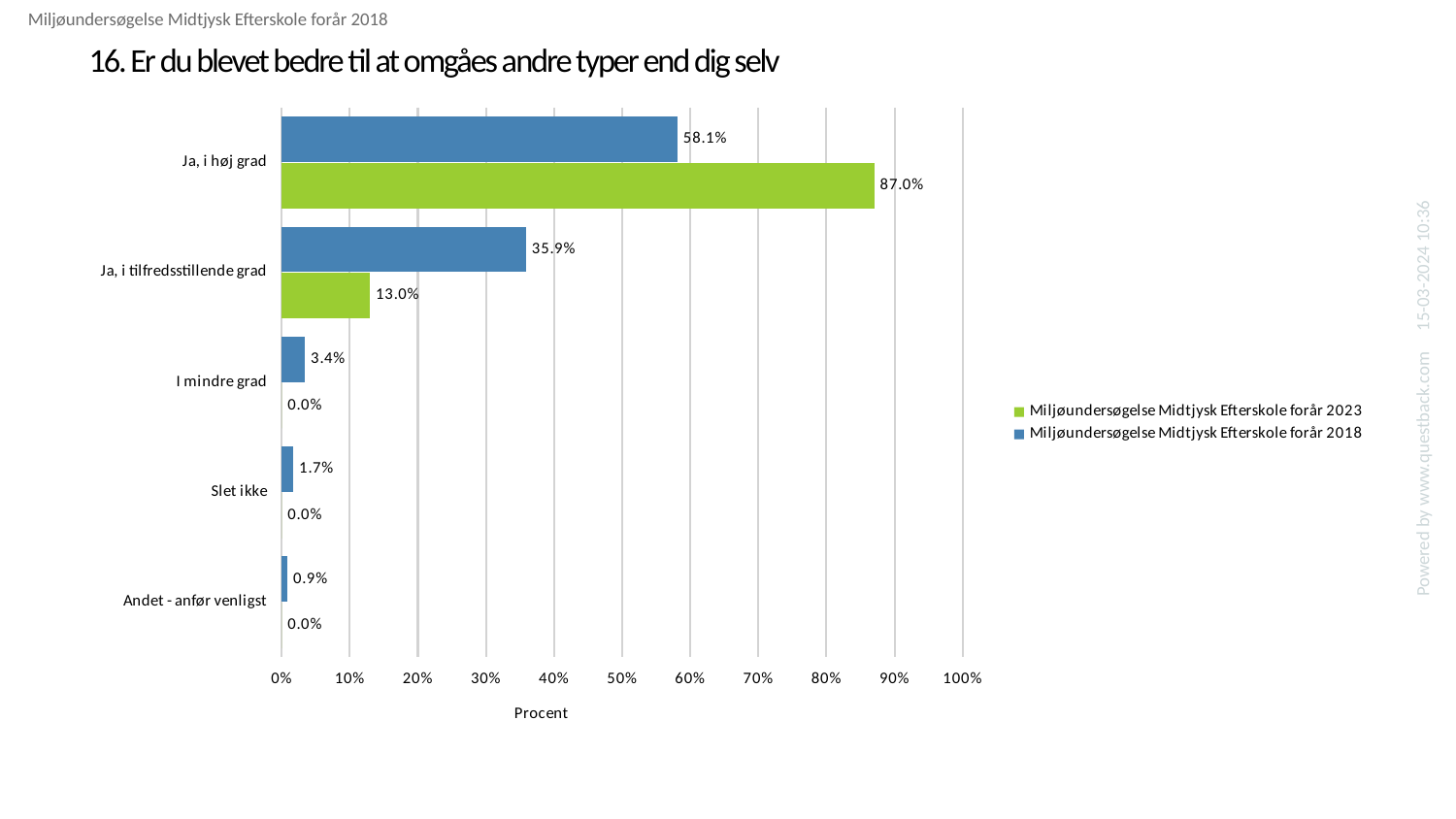
Which category has the lowest value in the 2018 series? Andet - anfør venligst What is the value for "Ja, i tilfredsstillende grad" in the Miljøundersøgelse Midtjysk Efterskole forår 2018 series? 35.9% For "Ja, i tilfredsstillende grad", which series has the larger value, 2018 or 2023? 2018 What is the difference between the 2023 and 2018 values for "Ja, i høj grad"? 28.9% What is the label of the x axis? Procent Which category has the highest value in the 2018 series? Ja, i høj grad What kind of chart is shown on the slide? Bar chart How many categories are shown on the chart? 5 How many series does the legend list? 2 What is the value for "Slet ikke" in the 2023 series? 0.0% What is the value for "Ja, i høj grad" in the Miljøundersøgelse Midtjysk Efterskole forår 2023 series? 87.0% What is the value for "I mindre grad" in the 2018 series? 3.4%